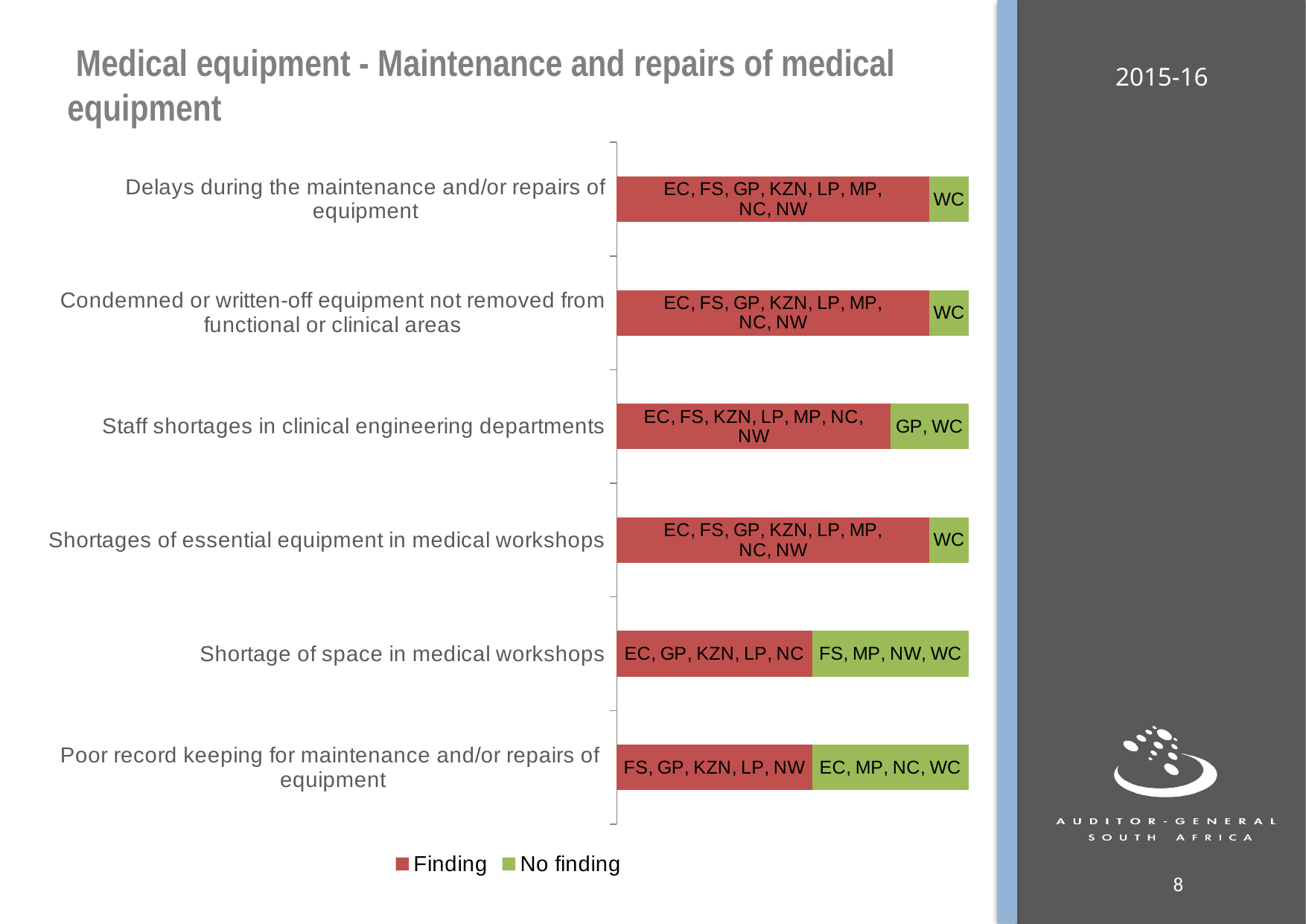
What are the two series named in the legend? Finding and No finding Which provinces are listed in the 'Finding' segment for 'Shortage of space in medical workshops'? EC, GP, KZN, LP, NC Which province is listed in the 'No finding' segment for 'Delays during the maintenance and/or repairs of equipment'? WC Which provinces are listed in the 'No finding' segment for 'Poor record keeping for maintenance and/or repairs of equipment'? EC, MP, NC, WC Which provinces are listed in the 'Finding' segment for 'Condemned or written-off equipment not removed from functional or clinical areas'? EC, FS, GP, KZN, LP, MP, NC, NW How many provinces are listed in the 'Finding' segment for 'Poor record keeping for maintenance and/or repairs of equipment'? 5 Which provinces are listed in the 'No finding' segment for 'Staff shortages in clinical engineering departments'? GP, WC What colour represents the 'Finding' series in the chart? Red Which has more provinces in the 'Finding' segment: 'Staff shortages in clinical engineering departments' or 'Shortage of space in medical workshops'? Staff shortages in clinical engineering departments What kind of chart is shown on the slide? Stacked bar chart How many series does the legend list? 2 How many categories (findings) are plotted on the chart? 6